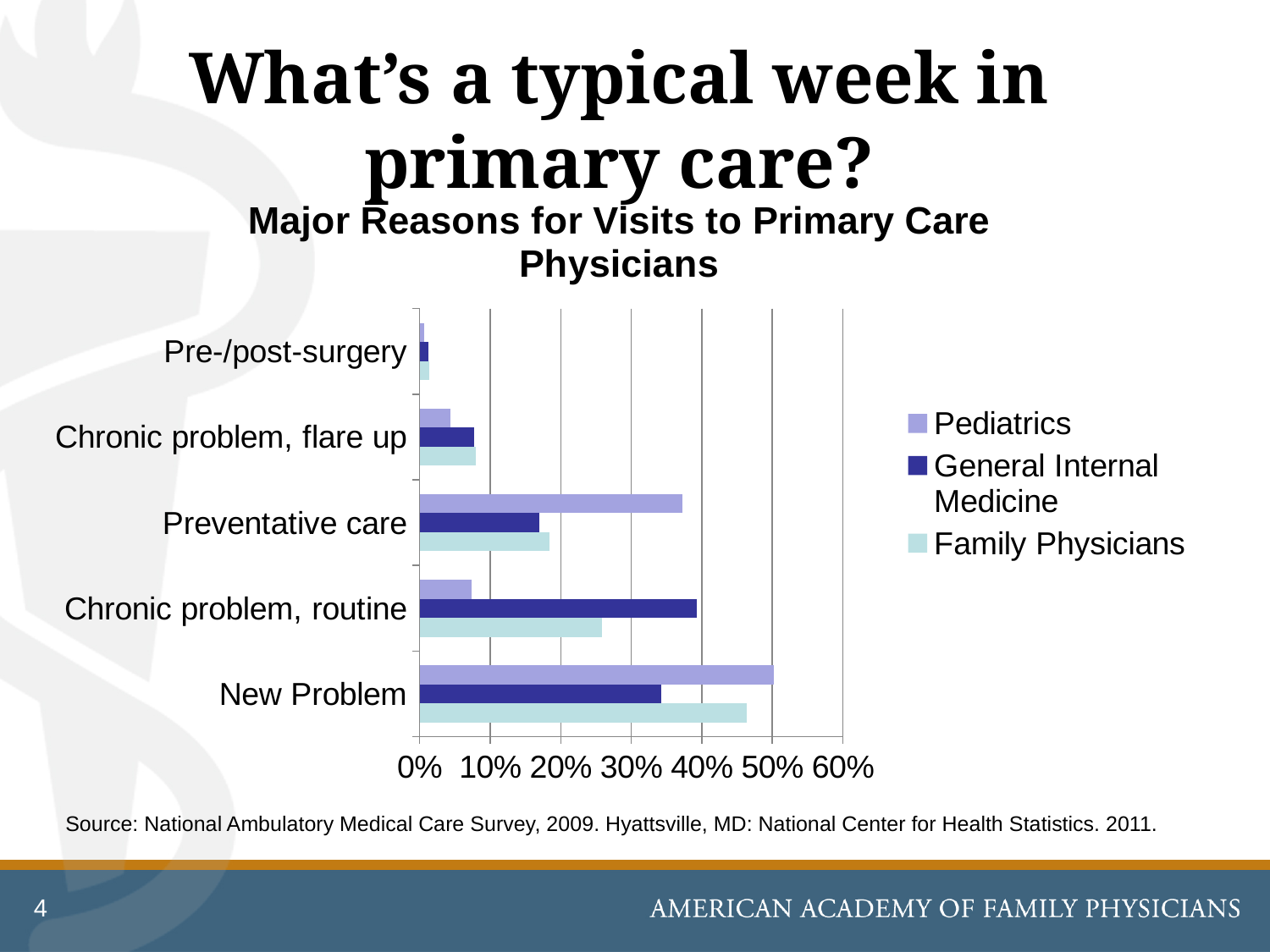
For Preventative care, which is larger: Pediatrics or General Internal Medicine? Pediatrics How many series does the legend list? 3 Is the General Internal Medicine value for Chronic problem, routine greater or less than 30%? greater What kind of chart is shown on the slide? Bar chart Which series is shown in the darkest blue bars? General Internal Medicine Is the Family Physicians value for Preventative care greater or less than 20%? less For Pediatrics, which reason for visit has the highest value? New Problem How many visit-reason categories are shown on the chart? 5 For General Internal Medicine, which reason for visit has the highest value? Chronic problem, routine For Family Physicians, which reason for visit has the lowest value? Pre-/post-surgery What is the title of the chart? Major Reasons for Visits to Primary Care Physicians For New Problem, which is larger: Family Physicians or General Internal Medicine? Family Physicians